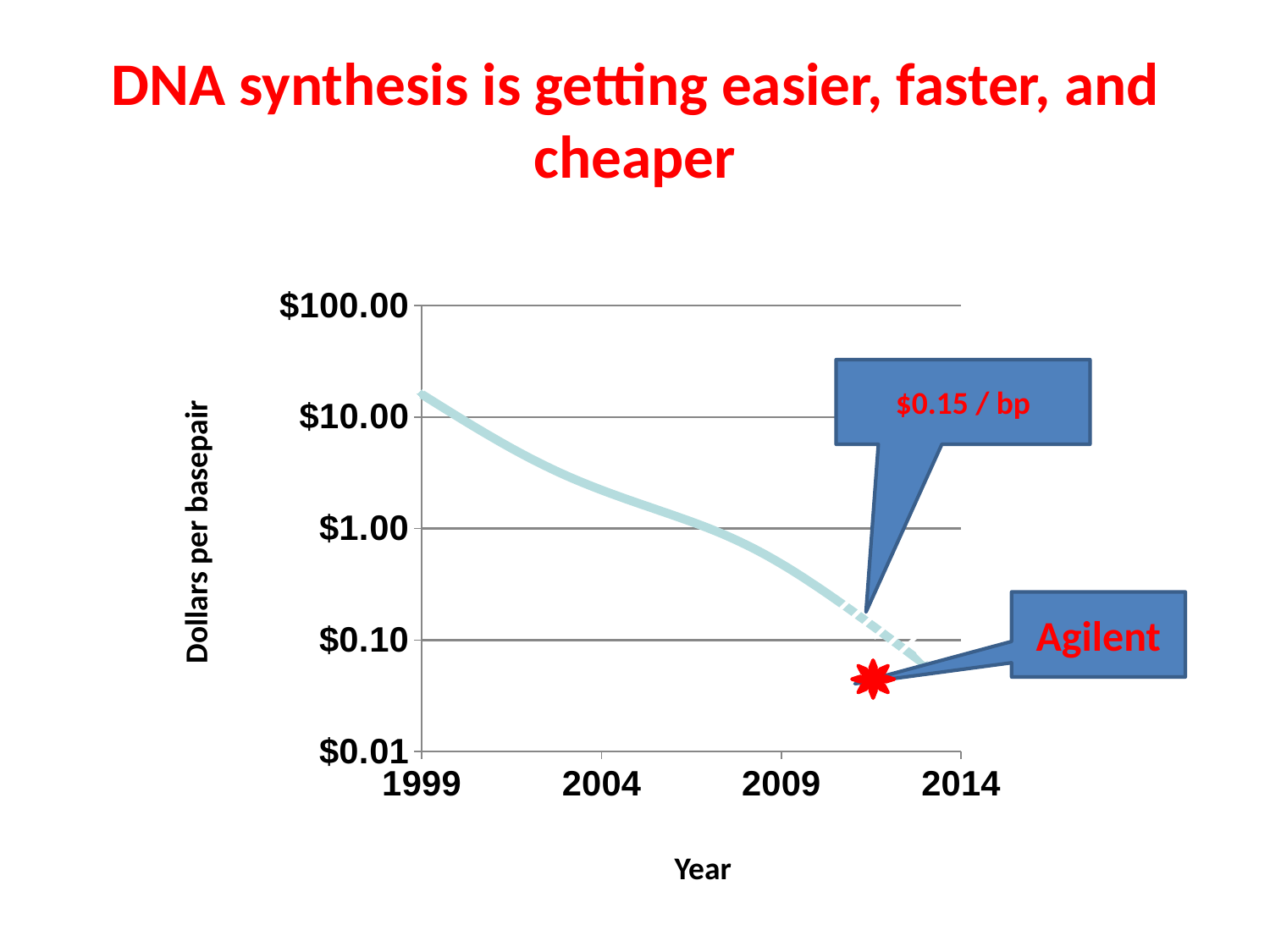
What is the highest value shown on the y axis? $100.00 What kind of chart is shown on the slide? line chart Does the dollars per basepair value rise or fall from 1999 to 2014? fall Is the value for 2009 greater or less than $1.00? less Which year has the higher dollars per basepair value, 1999 or 2009? 1999 Is the value for 2004 greater or less than $10.00? less What is the label of the y axis? Dollars per basepair What price per basepair does the callout on the chart give? $0.15 / bp Is the value for 2004 greater or less than $1.00? greater What is the label of the x axis? Year